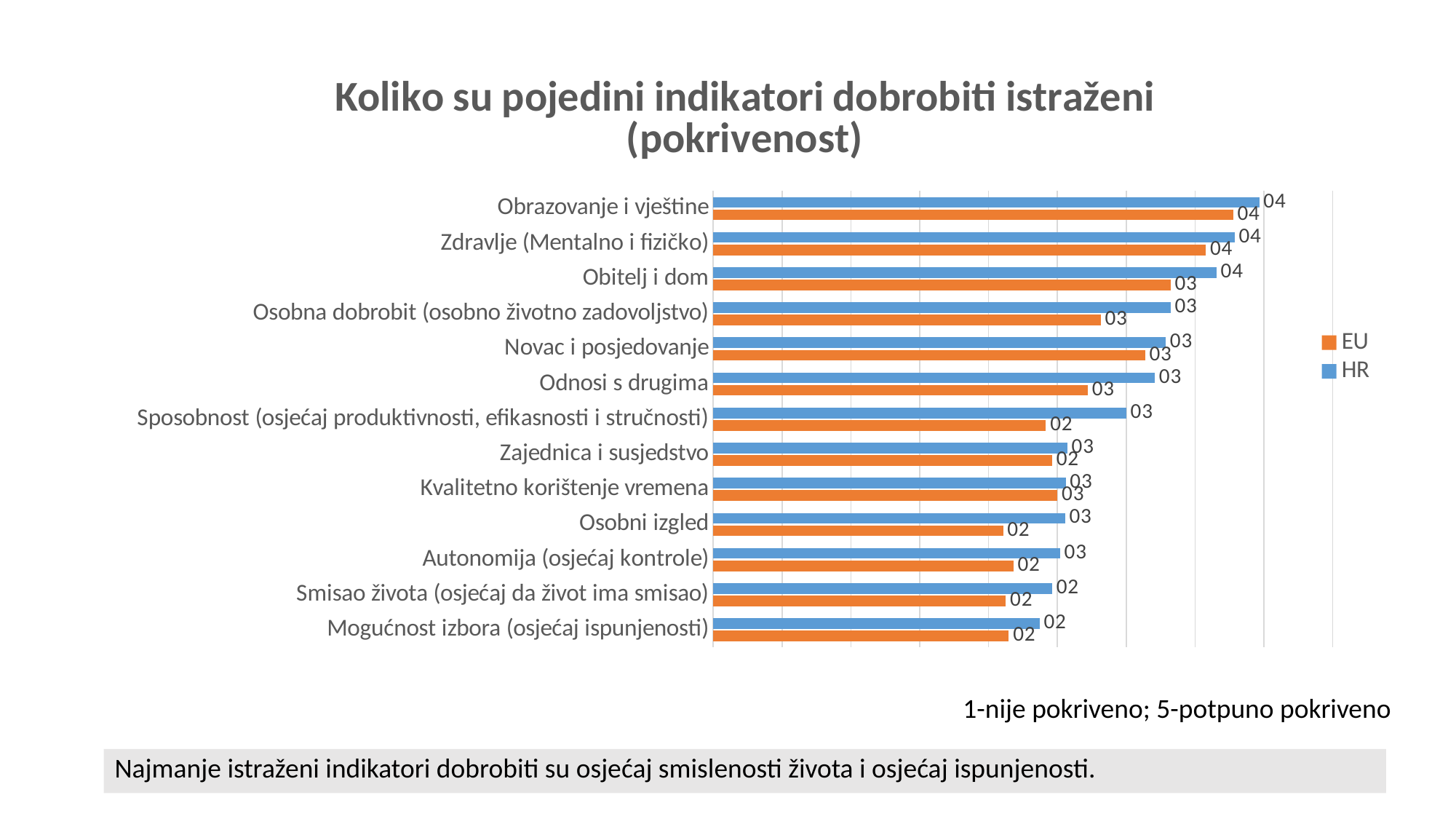
Which category has the highest HR value? Obrazovanje i vještine What is the HR value for Smisao života (osjećaj da život ima smisao)? 02 What is the HR value for Osobni izgled? 03 What is the EU value for Sposobnost (osjećaj produktivnosti, efikasnosti i stručnosti)? 02 What kind of chart is shown on the slide? bar chart How many series does the legend list? 2 Which series is shown in orange in the legend? EU What is the title of the chart? Koliko su pojedini indikatori dobrobiti istraženi (pokrivenost) What is the HR value for Obrazovanje i vještine? 04 For Obitelj i dom, which series has the larger value, EU or HR? HR What is the EU value for Kvalitetno korištenje vremena? 03 How many categories (indicators) are plotted on the chart? 13